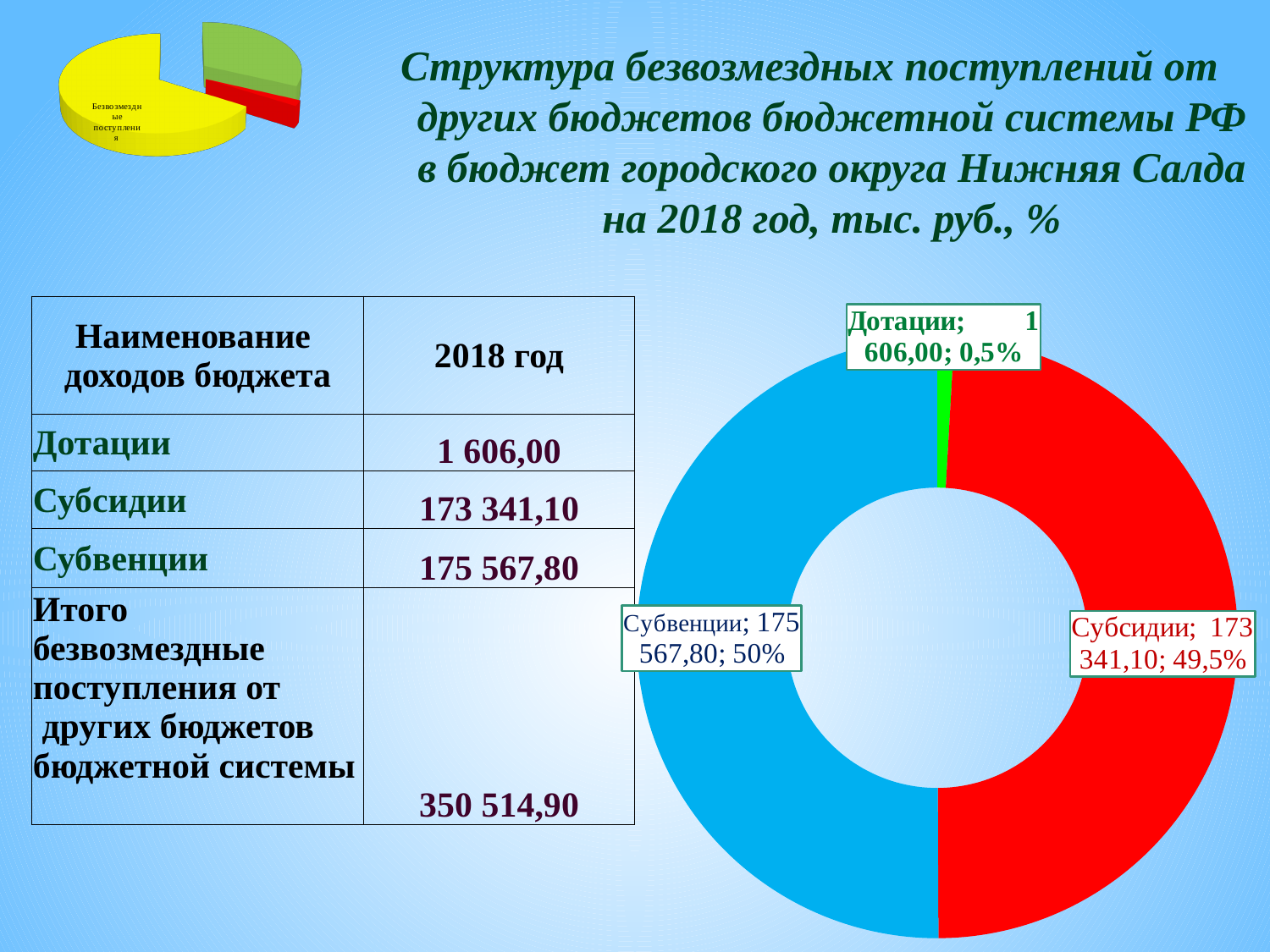
What share of the doughnut chart does Субвенции represent? 50% What share of the doughnut chart does Дотации represent? 0,5% What value is shown for Дотации in the doughnut chart? 1 606,00 Which category has the smallest value in the doughnut chart? Дотации What value is shown for Субвенции in the doughnut chart? 175 567,80 What share of the doughnut chart does Субсидии represent? 49,5% What is the difference between the values for Субвенции and Субсидии in the doughnut chart? 2 226,70 What colour is the Субсидии slice in the doughnut chart? Red What type of chart is the large chart on the right of the slide? Doughnut chart How many categories are shown in the doughnut chart? 3 Which category has the largest value in the doughnut chart? Субвенции What value is shown for Субсидии in the doughnut chart? 173 341,10